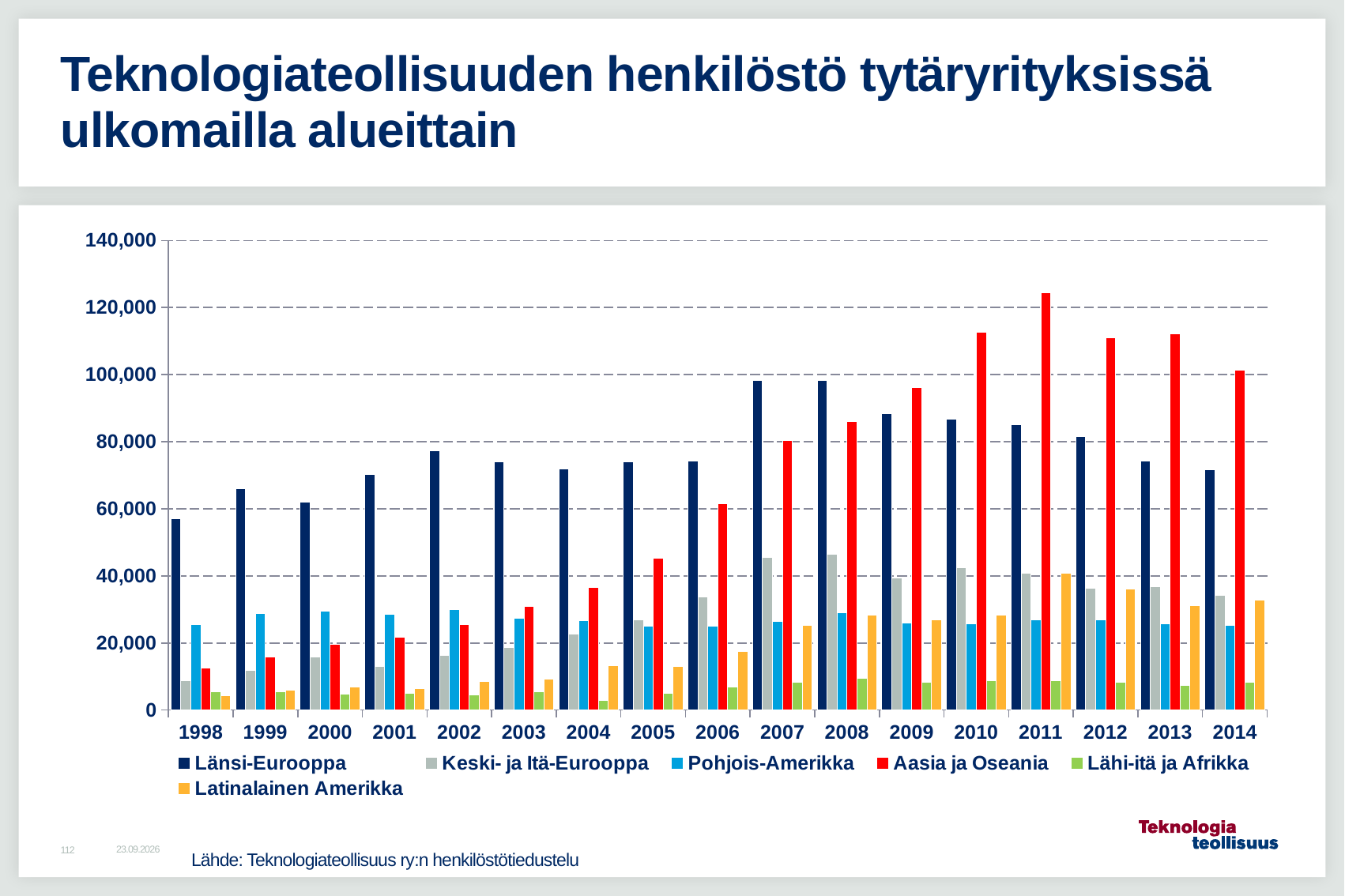
Is the value for Aasia ja Oseania in 2011 greater or less than 120,000? greater In which year is the value for Aasia ja Oseania highest? 2011 In 2006, which is larger: Länsi-Eurooppa or Aasia ja Oseania? Länsi-Eurooppa In 2014, which is larger: Länsi-Eurooppa or Aasia ja Oseania? Aasia ja Oseania How many years are shown on the x axis? 17 Does the value for Aasia ja Oseania rise or fall from 1998 to 2011? rise Is the value for Keski- ja Itä-Eurooppa in 2008 greater or less than 40,000? greater Is the value for Länsi-Eurooppa in 1998 greater or less than 60,000? less How many series does the legend list? 6 In which year is the value for Länsi-Eurooppa lowest? 1998 What kind of chart is shown on the slide? bar chart